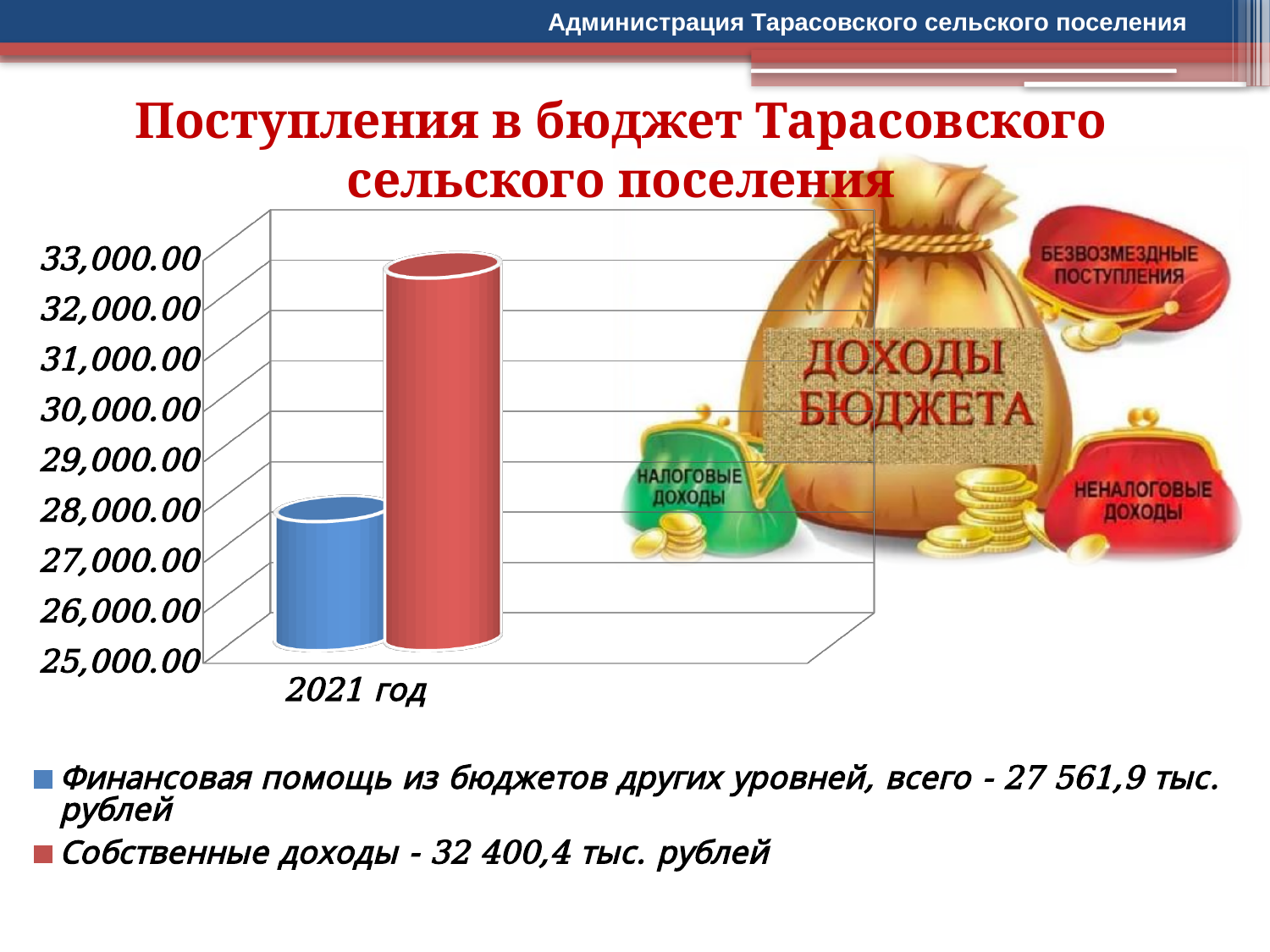
What value does the legend give for 'Собственные доходы'? 32 400,4 тыс. рублей Is the value for 'Собственные доходы' greater or less than 30,000.00? greater Is the value for 'Собственные доходы' larger or smaller than the value for 'Финансовая помощь из бюджетов других уровней'? larger What kind of chart is shown on the slide? bar chart Is the value for 'Финансовая помощь из бюджетов других уровней' greater or less than 28,000.00? less Which series has the lower value in the chart? Финансовая помощь из бюджетов других уровней What is the difference between 'Собственные доходы' and 'Финансовая помощь из бюджетов других уровней'? 4 838,5 тыс. рублей What colour is the bar for 'Собственные доходы'? red Which series has the higher value in the chart? Собственные доходы How many series does the legend list? 2 How many categories are shown on the x axis of the chart? 1 What value does the legend give for 'Финансовая помощь из бюджетов других уровней, всего'? 27 561,9 тыс. рублей